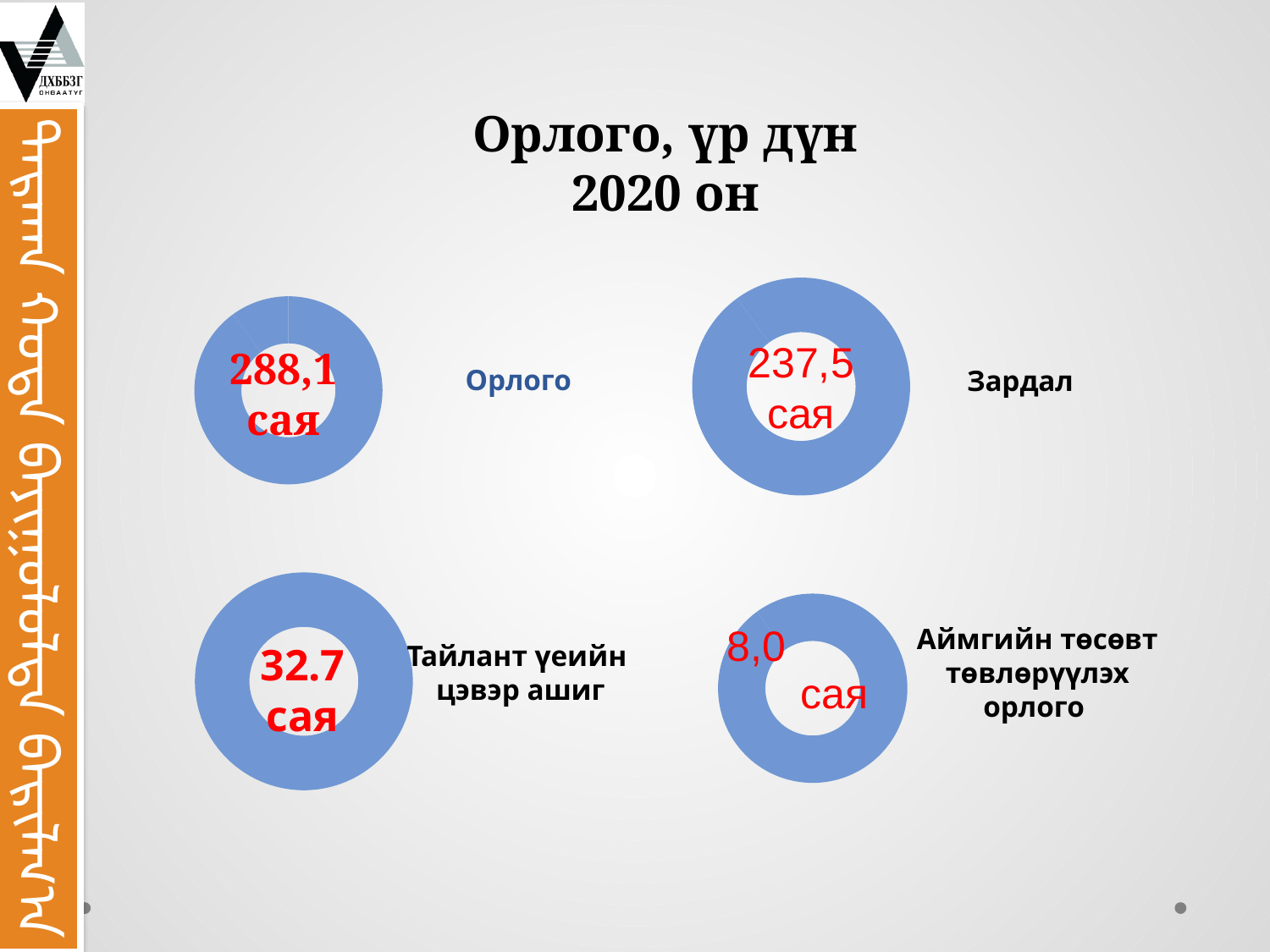
What is the difference between the Орлого value and the Зардал value? 50,6 сая What value is shown in the centre of the donut chart labelled Орлого? 288,1 сая What value is shown in the centre of the donut chart labelled Зардал? 237,5 сая Which of the four labelled figures on the slide has the highest value? Орлого Which of the four labelled figures on the slide has the lowest value? Аймгийн төсөвт төвлөрүүлэх орлого What value is shown in the donut chart labelled Тайлант үеийн цэвэр ашиг? 32.7 сая Which is larger, the value for Тайлант үеийн цэвэр ашиг or the value for Аймгийн төсөвт төвлөрүүлэх орлого? Тайлант үеийн цэвэр ашиг What kind of chart is used for each of the four figures on the slide? Donut chart What value is shown in the donut chart labelled Аймгийн төсөвт төвлөрүүлэх орлого? 8,0 сая What is the title of the slide containing the four donut charts? Орлого, үр дүн 2020 он Which is larger, the value for Орлого or the value for Зардал? Орлого How many donut charts are on the slide? 4